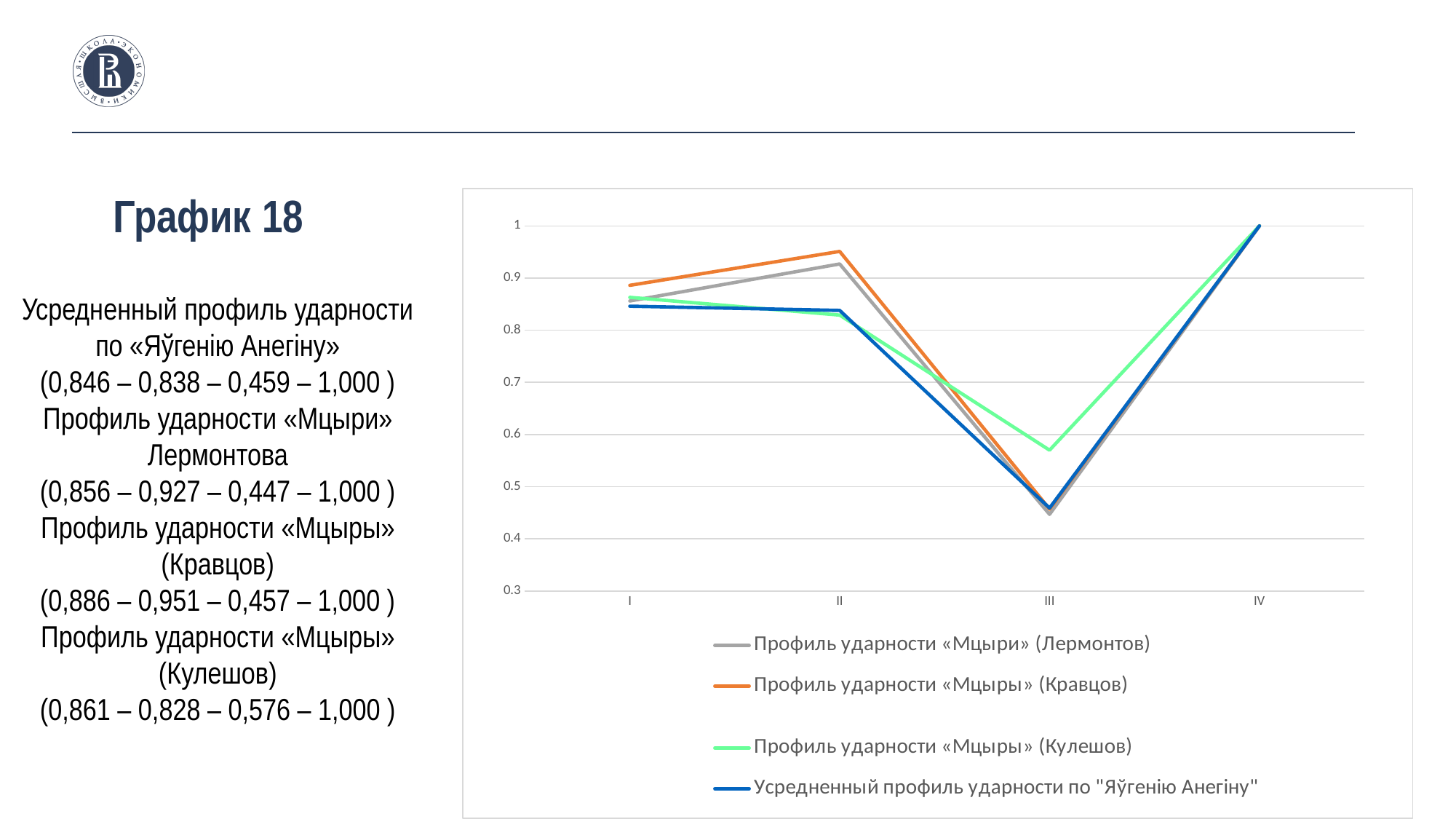
What is the value of «Профиль ударности «Мцыры» (Кулешов)» at category III? 0,576 What is the value of «Профиль ударности «Мцыры» (Кравцов)» at category II? 0,951 What is the difference between the values of «Профиль ударности «Мцыры» (Кравцов)» and «Профиль ударности «Мцыри» (Лермонтов)» at category II? 0,024 Which series has the highest value at category II? Профиль ударности «Мцыры» (Кравцов) Is the value for «Профиль ударности «Мцыри» (Лермонтов)» at category III greater or less than 0.5? less What colour is the line for «Профиль ударности «Мцыры» (Кравцов)»? orange Which series has the highest value at category III? Профиль ударности «Мцыры» (Кулешов) Is the value for «Профиль ударности «Мцыры» (Кулешов)» at category III greater or less than 0.5? greater What kind of chart is shown on the slide? line chart Do the values of all series rise or fall from category II to category III? fall How many categories are on the x axis of the chart? 4 How many series does the legend of the chart list? 4